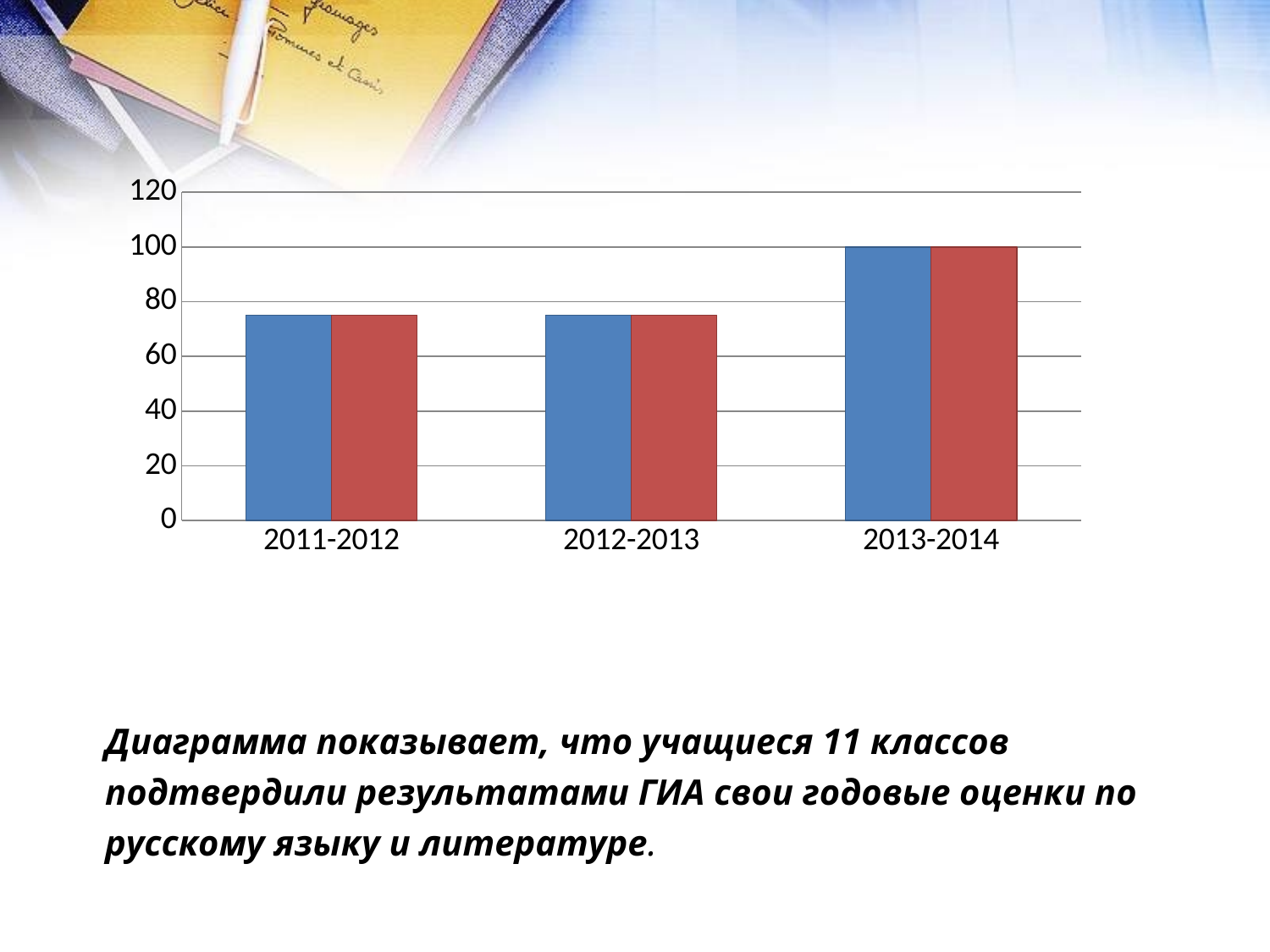
How many categories are shown on the x axis of the chart? 3 Which is larger, the blue bar for 2011-2012 or the blue bar for 2013-2014? 2013-2014 What is the value of the red bar for 2013-2014? 100 Do the values rise or fall from 2011-2012 to 2013-2014? rise What is the value of the blue bar for 2013-2014? 100 What is the highest value shown on the vertical axis of the chart? 120 How many bars are shown for each category in the chart? 2 Which category has the highest bars in the chart? 2013-2014 Is the value of the blue bar for 2013-2014 greater or less than 80? greater What kind of chart is shown on the slide? bar chart Is the value of the red bar for 2012-2013 greater or less than 80? less Is the value of the blue bar for 2011-2012 greater or less than 60? greater